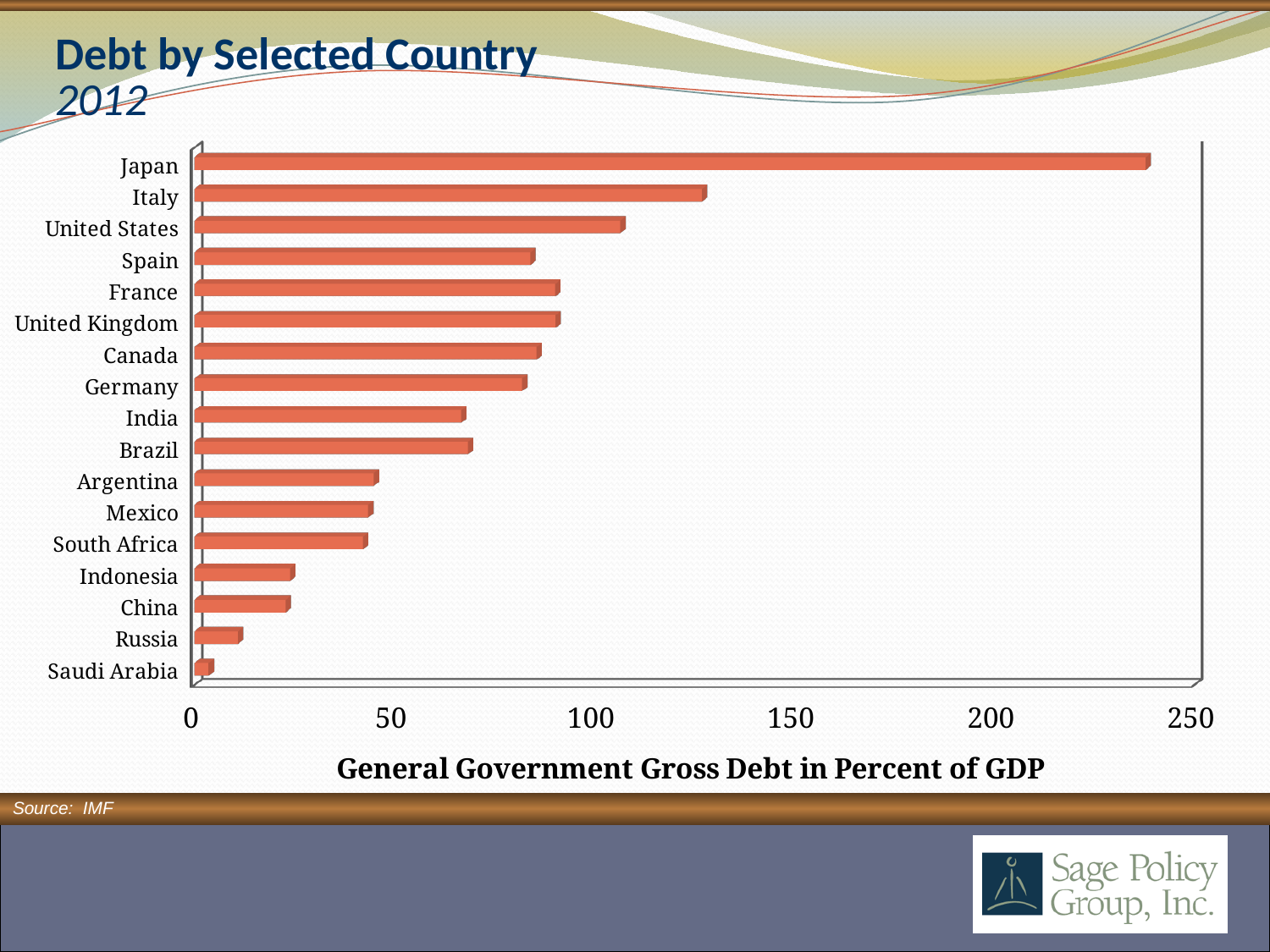
Which country has the highest general government gross debt in percent of GDP? Japan Is the value for Germany greater or less than 50? greater Which country has the lowest general government gross debt in percent of GDP? Saudi Arabia Is the value for Italy greater or less than 100? greater Is the value for Spain greater or less than 100? less What kind of chart is shown on the slide? bar chart How many countries are shown in the chart? 17 Which has a higher debt in percent of GDP, Italy or the United States? Italy Which has a higher debt in percent of GDP, Argentina or Indonesia? Argentina What is the label on the horizontal axis of the chart? General Government Gross Debt in Percent of GDP